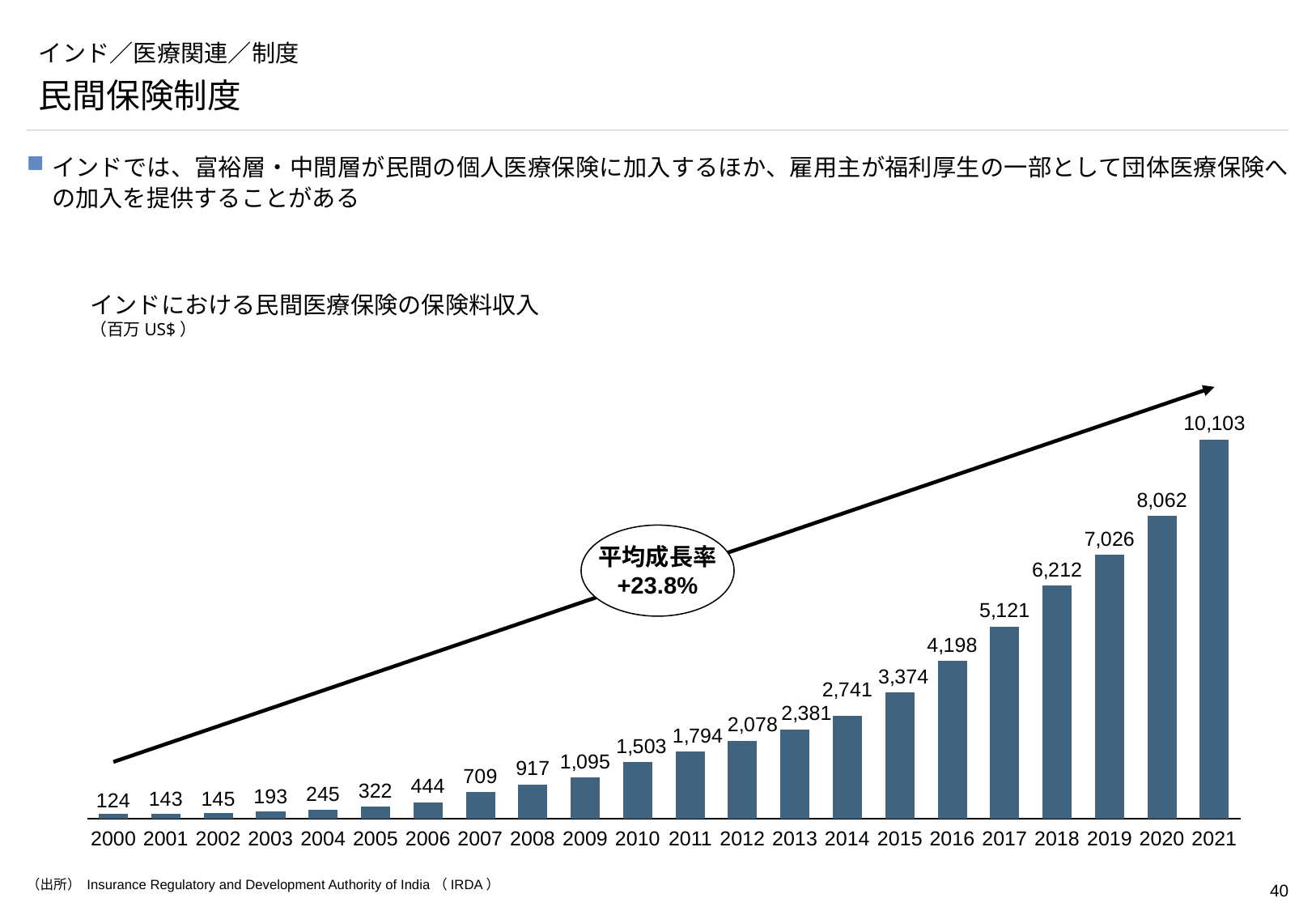
Which is larger, the value for 2018 or the value for 2019? 2019 What is the value for 2021? 10,103 What is the value for 2016? 4,198 What is the value for 2000? 124 What is the difference between the values for 2015 and 2014? 633 How many years are shown on the x axis? 22 What kind of chart is this? bar chart Do the values rise or fall from 2000 to 2021? rise Which year has the highest value? 2021 What is the difference between the values for 2021 and 2020? 2,041 Which year has the lowest value? 2000 What is the value for 2010? 1,503